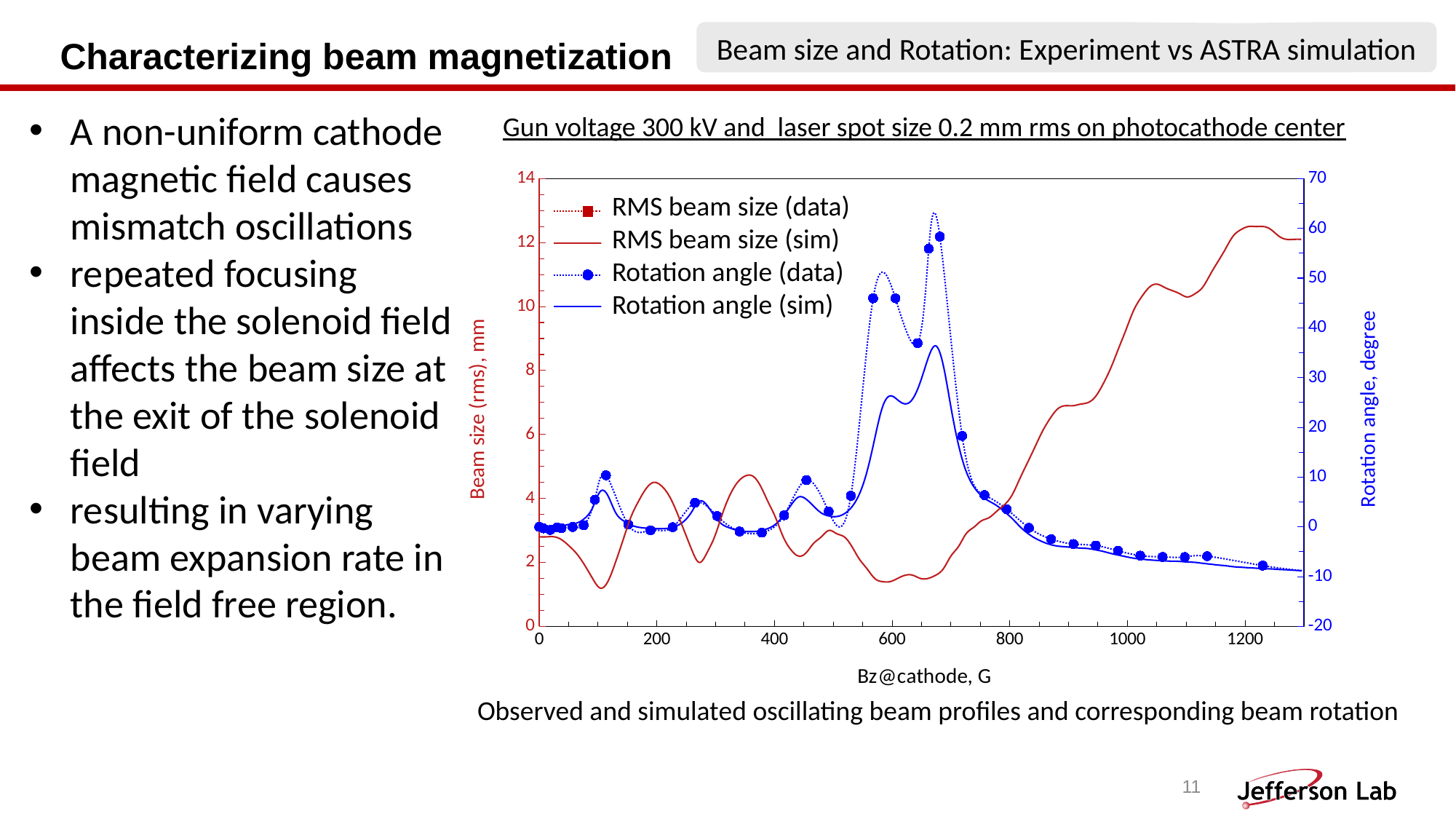
Does the RMS beam size (sim) curve rise or fall between 800 G and 1200 G? rise Is the peak Rotation angle (data) value near 680 G greater or less than 50 degrees? greater Which reaches a higher peak rotation angle, Rotation angle (data) or Rotation angle (sim)? Rotation angle (data) What is the title of the x axis of the chart? Bz@cathode, G What kind of chart is shown on the slide? Line chart What is the label of the right-hand y axis of the chart? Rotation angle, degree How many series does the chart legend list? 4 Is the RMS beam size (sim) value at 1200 G greater or less than 10 mm? greater Is the Rotation angle (sim) value at 1200 G greater or less than 0 degrees? less Does the Rotation angle (data) curve rise or fall between 700 G and 1200 G? fall